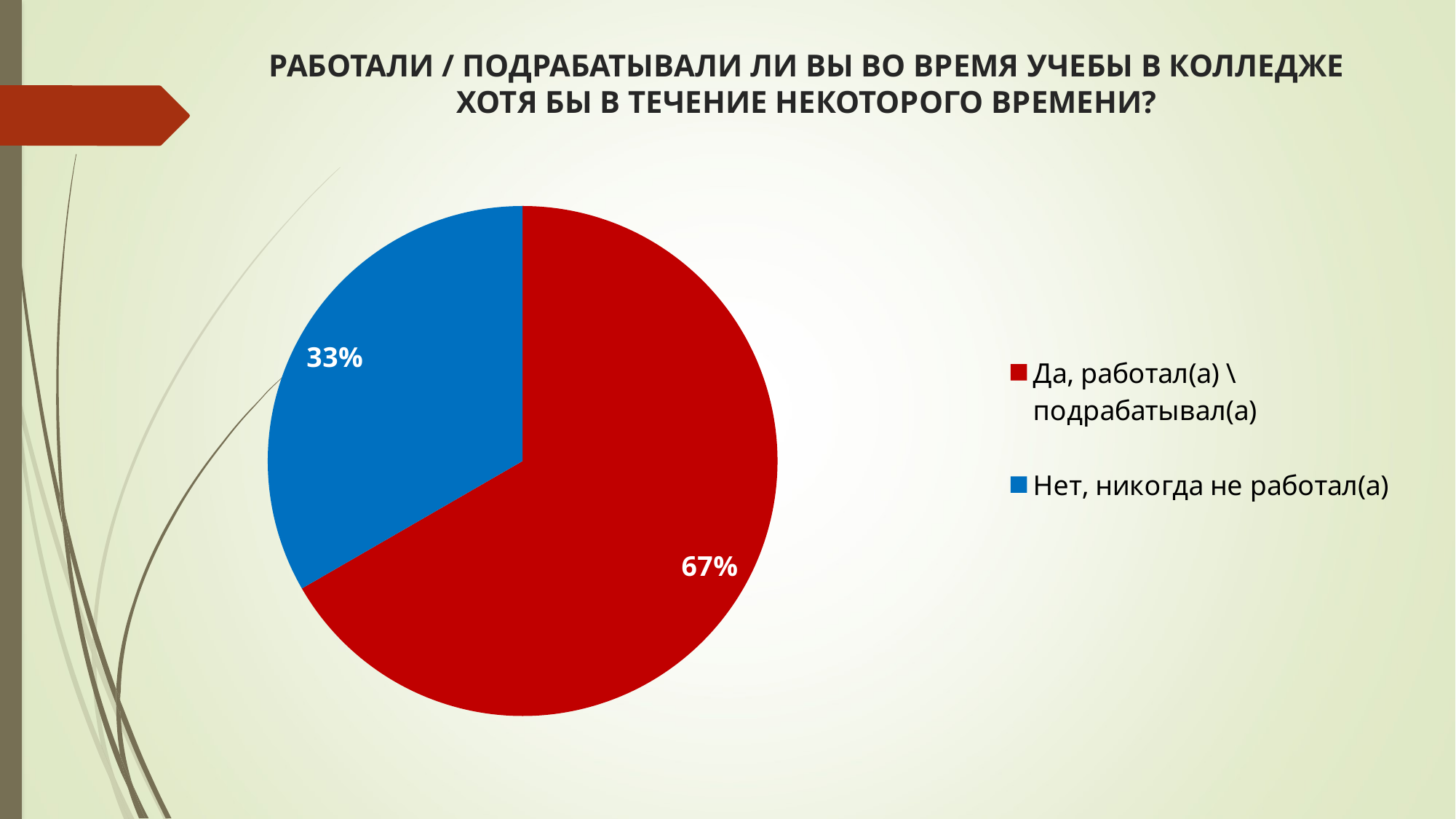
What colour is the slice for "Да, работал(а) \ подрабатывал(а)"? red Which category has the smallest slice of the pie? Нет, никогда не работал(а) What colour is the slice for "Нет, никогда не работал(а)"? blue What share of the pie do the two slices add up to? 100% How many entries does the legend list? 2 What is the difference in percentage points between the "Да, работал(а) \ подрабатывал(а)" slice and the "Нет, никогда не работал(а)" slice? 34% What kind of chart is shown on the slide? pie chart Which category has the largest slice of the pie? Да, работал(а) \ подрабатывал(а) Which is larger: the share for "Да, работал(а) \ подрабатывал(а)" or the share for "Нет, никогда не работал(а)"? Да, работал(а) \ подрабатывал(а) What share of the pie is labelled "Да, работал(а) \ подрабатывал(а)"? 67% How many slices does the pie chart have? 2 What share of the pie is labelled "Нет, никогда не работал(а)"? 33%